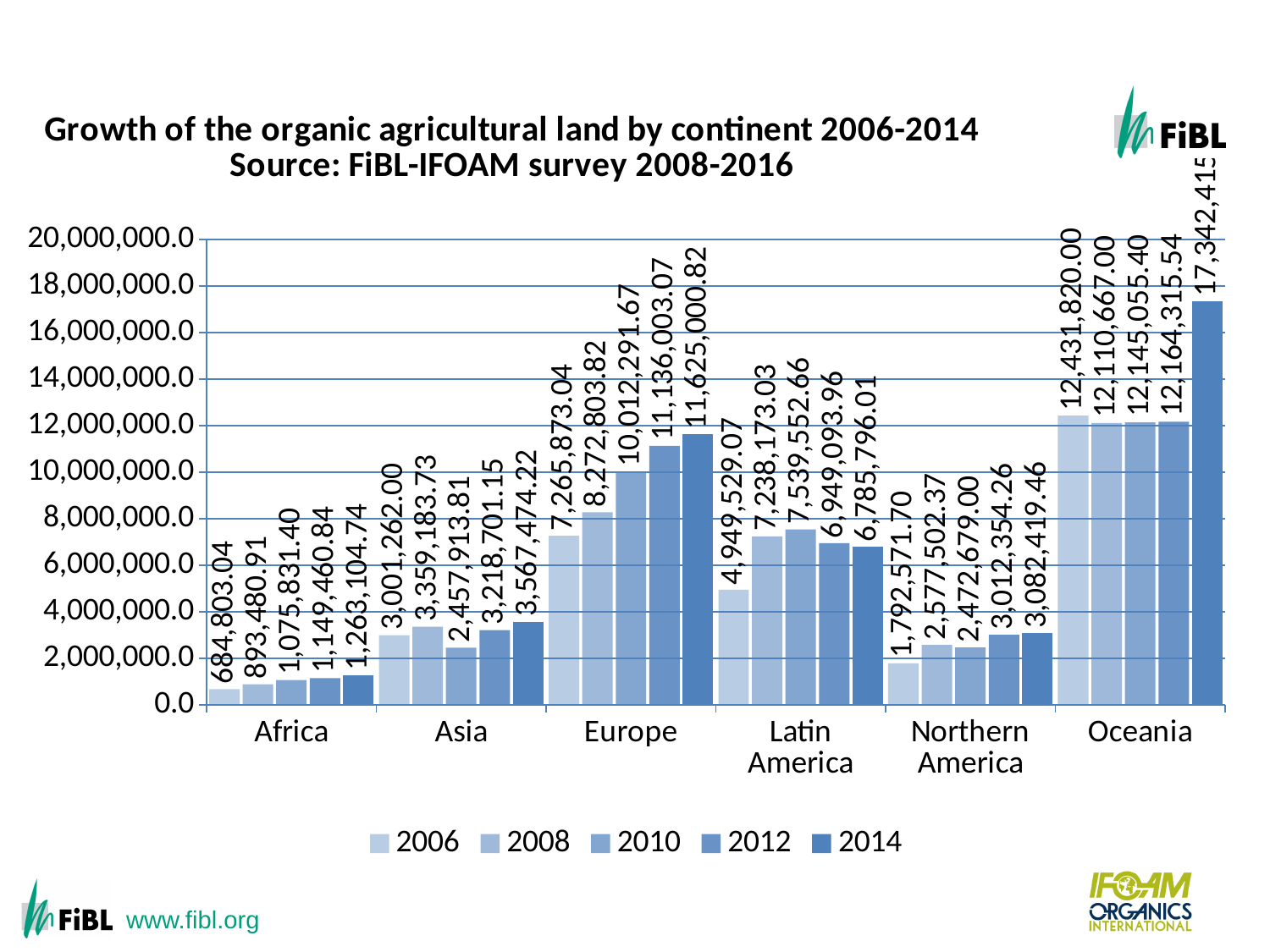
What is the value for Oceania in 2006? 12,431,820.00 What is the value for Northern America in 2012? 3,012,354.26 Which is larger, the 2010 value for Asia or the 2010 value for Northern America? Northern America What is the value for Latin America in 2008? 7,238,173.03 What is the value for Africa in 2006? 684,803.04 What is the value for Europe in 2014? 11,625,000.82 What is the difference between the 2014 and 2006 values for Africa? 578,301.70 Which continent has the lowest value in 2014? Africa What kind of chart is shown on the slide? bar chart How many series does the legend list? 5 Which continent has the highest value in 2006? Oceania Do the values for Europe rise or fall from 2006 to 2014? rise